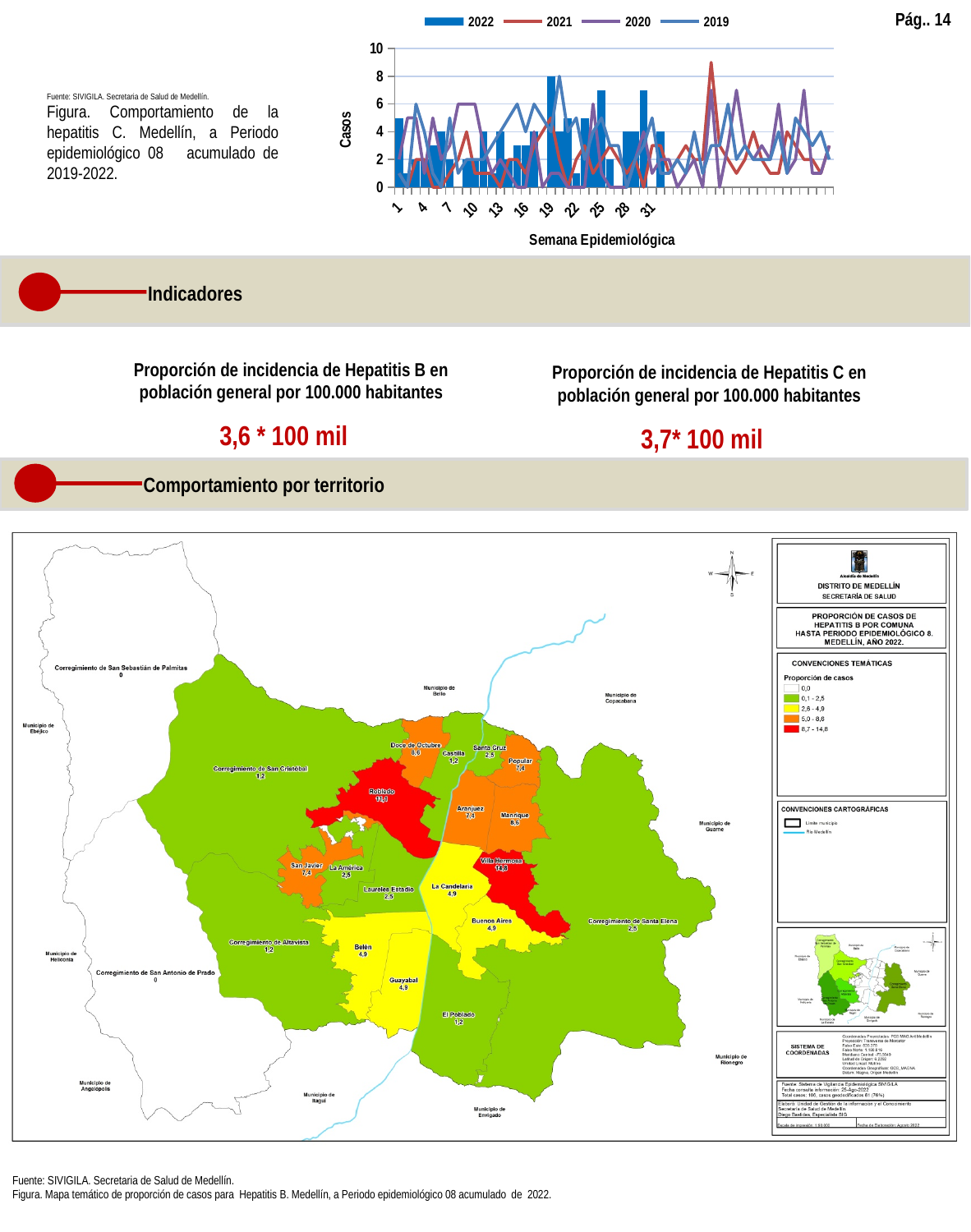
In the hepatitis C chart, is the 2022 value for week 19 greater or less than 6? greater On the hepatitis B map, what is the proportion of cases shown for Robledo? 11,4 What kind of chart is the hepatitis C chart at the top of the slide? bar and line chart In the hepatitis C chart, is the 2022 value for week 1 greater or less than 4? greater What is the title of the x axis of the hepatitis C chart? Semana Epidemiológica On the hepatitis B map, what is the proportion of cases shown for Villa Hermosa? 14,8 In the hepatitis C chart, is the highest value of the 2021 line greater or less than 8? greater In the hepatitis C chart, which series reaches the highest number of cases on the chart? 2021 What is the highest tick value shown on the y axis of the hepatitis C chart? 10 On the hepatitis B map, which comuna has the highest proportion of cases? Villa Hermosa How many series does the legend of the hepatitis C chart list? 4 In the hepatitis C chart, which year is plotted as bars rather than a line? 2022